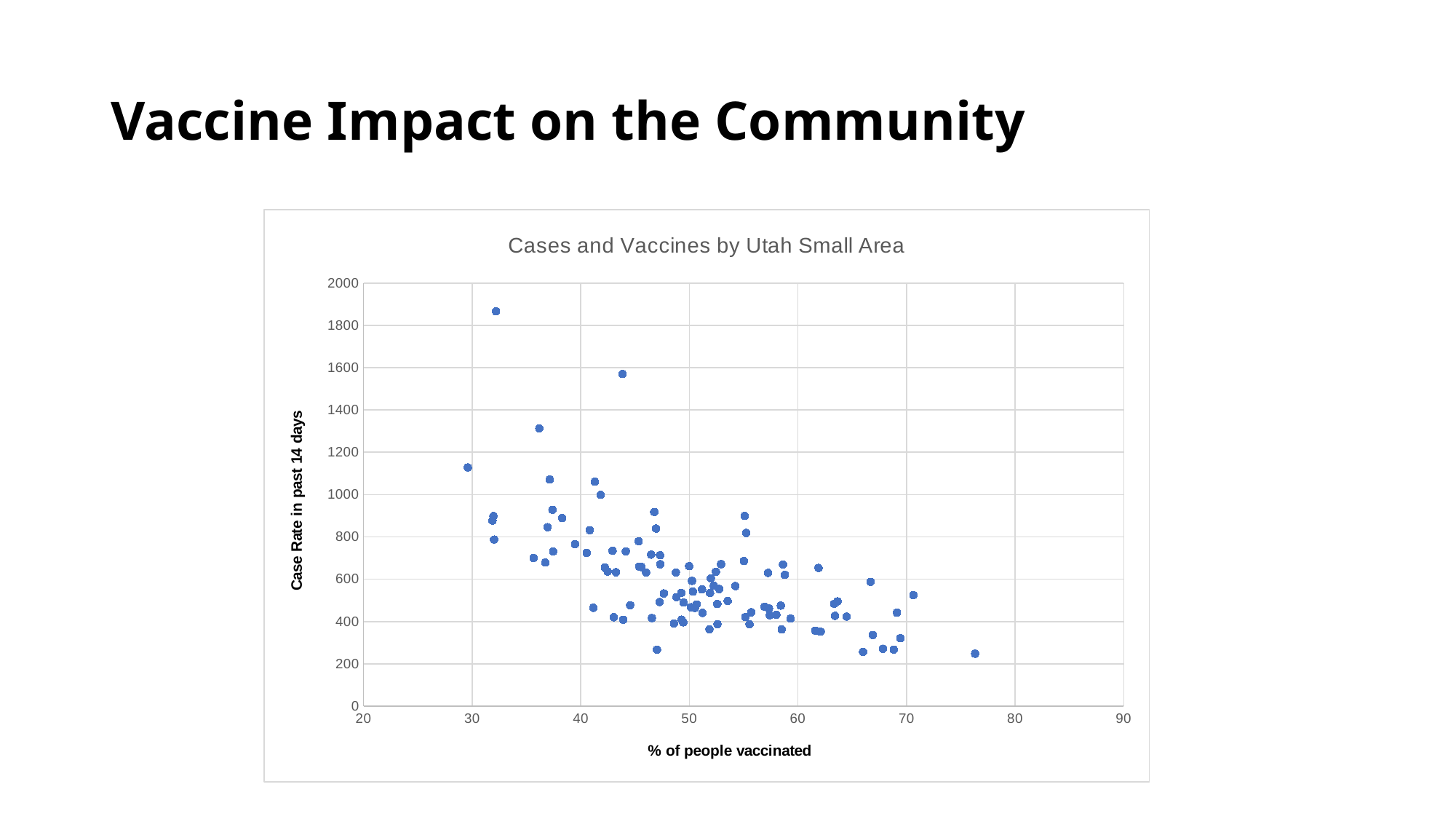
Which has the higher case rate, the leftmost point or the rightmost point on the chart? The leftmost point Are the case rates of all points with more than 60% of people vaccinated greater or less than 800? less Is the case rate of the leftmost point (the one with the lowest vaccination percentage) greater or less than 1000? greater Is the case rate of the highest point on the chart greater or less than 1800? greater As the percentage of people vaccinated increases along the x axis, does the case rate generally rise or fall? Fall What kind of chart is shown on the slide? Scatter plot What is the label of the vertical axis of the chart? Case Rate in past 14 days What is the title of the chart? Cases and Vaccines by Utah Small Area